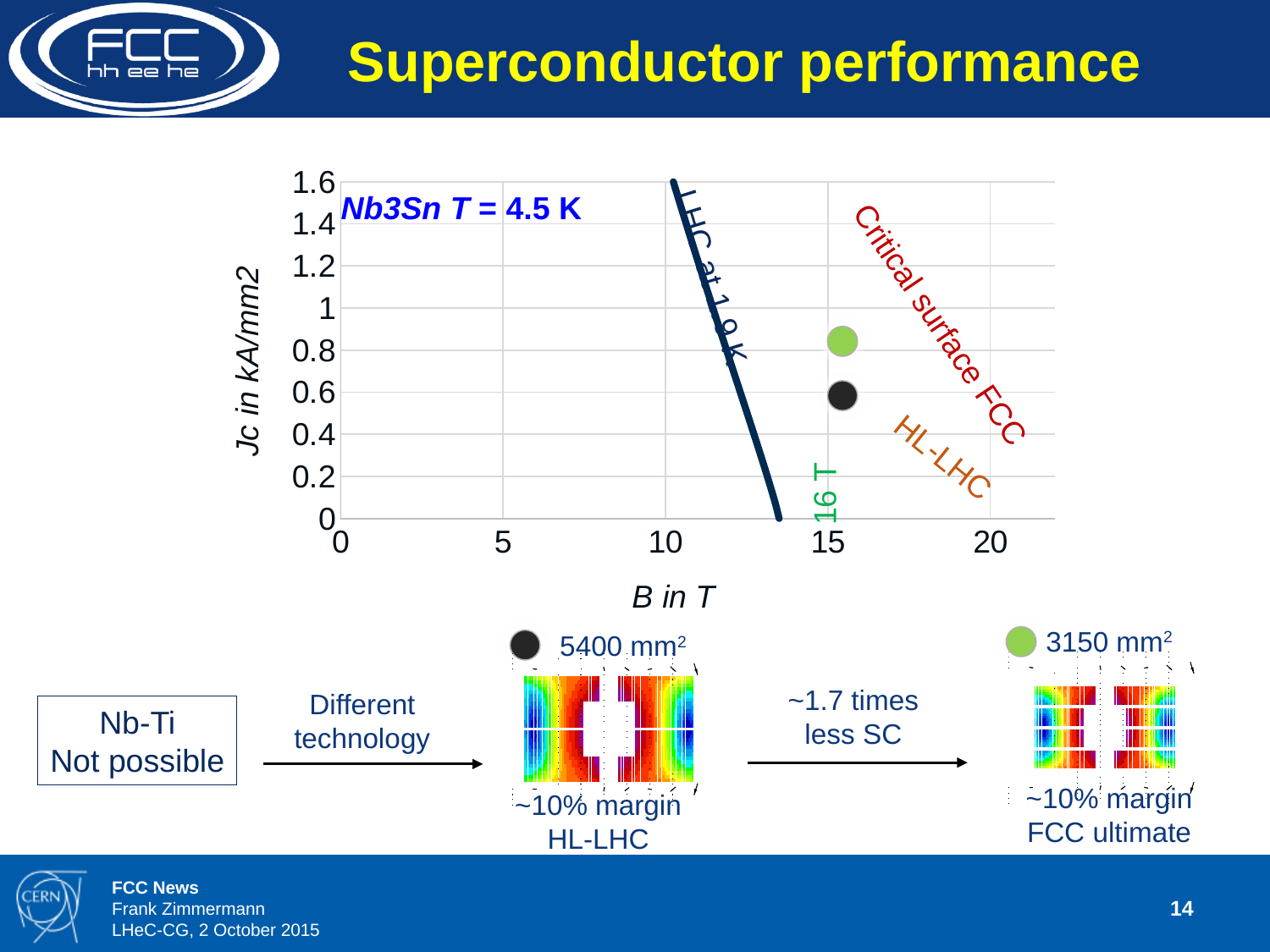
How many circular data markers are plotted on the chart? 2 Is the B value of the green FCC marker greater or less than 20 T? less What is the label of the y axis of the chart? Jc in kA/mm2 Is the B value of the black HL-LHC marker greater or less than 10 T? greater Is the Jc value of the black HL-LHC marker greater or less than 0.4 kA/mm2? greater Does the 'LHC at 1.9 K' line rise or fall as B increases? fall Which marker has the higher Jc value, the green FCC marker or the black HL-LHC marker? the green FCC marker What is the highest value shown on the y axis of the chart? 1.6 What is the highest value shown on the x axis of the chart? 20 What is the label of the x axis of the chart? B in T